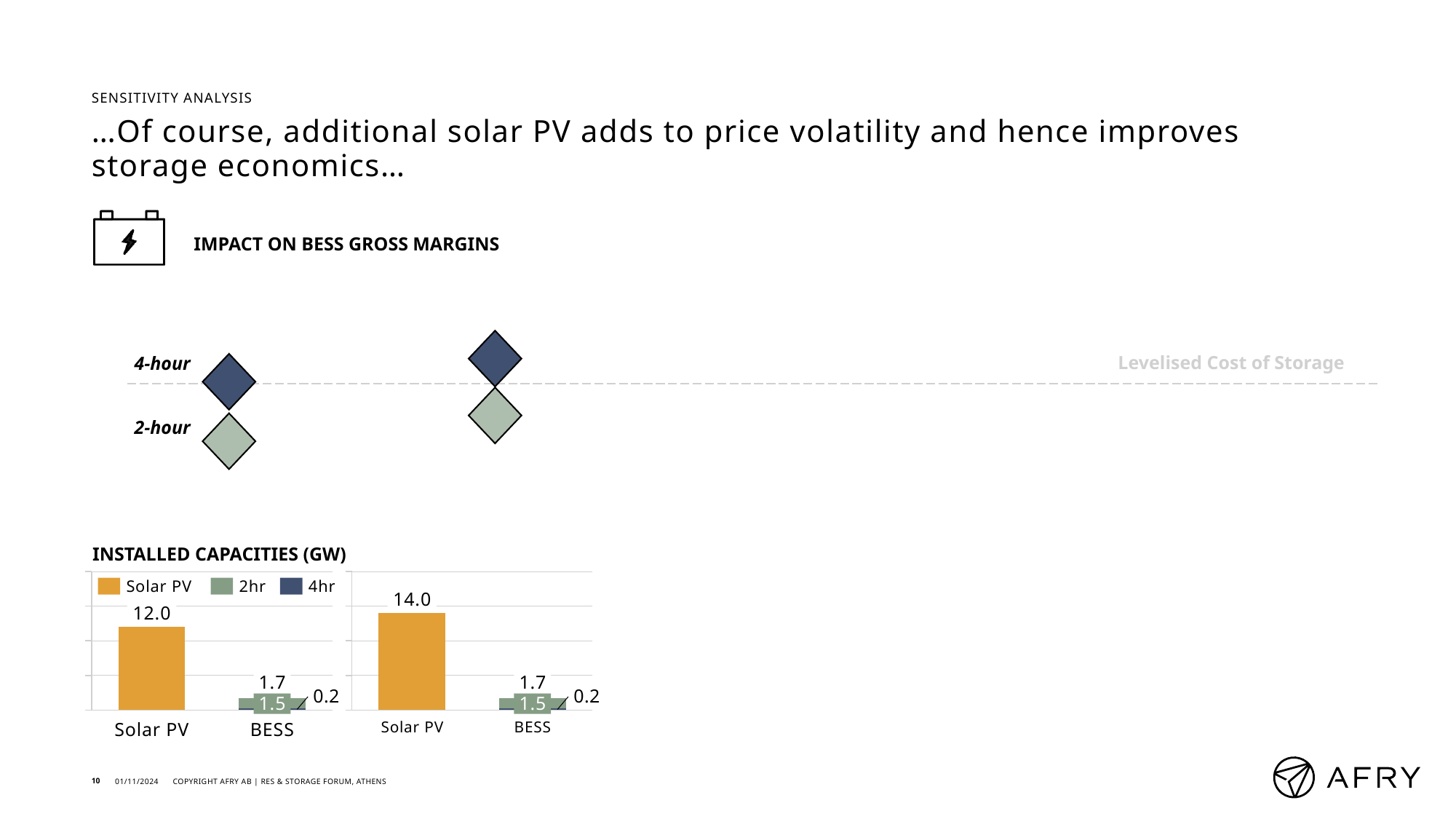
What is the difference between the Solar PV values in the right and left Installed Capacities charts? 2.0 In the left Installed Capacities chart, what is the 2hr value in the BESS bar? 1.5 What colour represents Solar PV in the Installed Capacities charts? orange In the left Installed Capacities chart, what is the value for Solar PV? 12.0 In the left Installed Capacities chart, what is the difference between the Solar PV value and the BESS total? 10.3 How many series does the legend of the Installed Capacities charts list? 3 In the right Installed Capacities chart, what is the value for Solar PV? 14.0 In the left Installed Capacities chart, what is the total of the stacked BESS bar? 1.7 Which Installed Capacities chart has the larger Solar PV value, the left or the right? right What type of chart is used for the Installed Capacities charts? bar chart In the right Installed Capacities chart, what is the total of the stacked BESS bar? 1.7 In the right Installed Capacities chart, what is the 4hr value in the BESS bar? 0.2